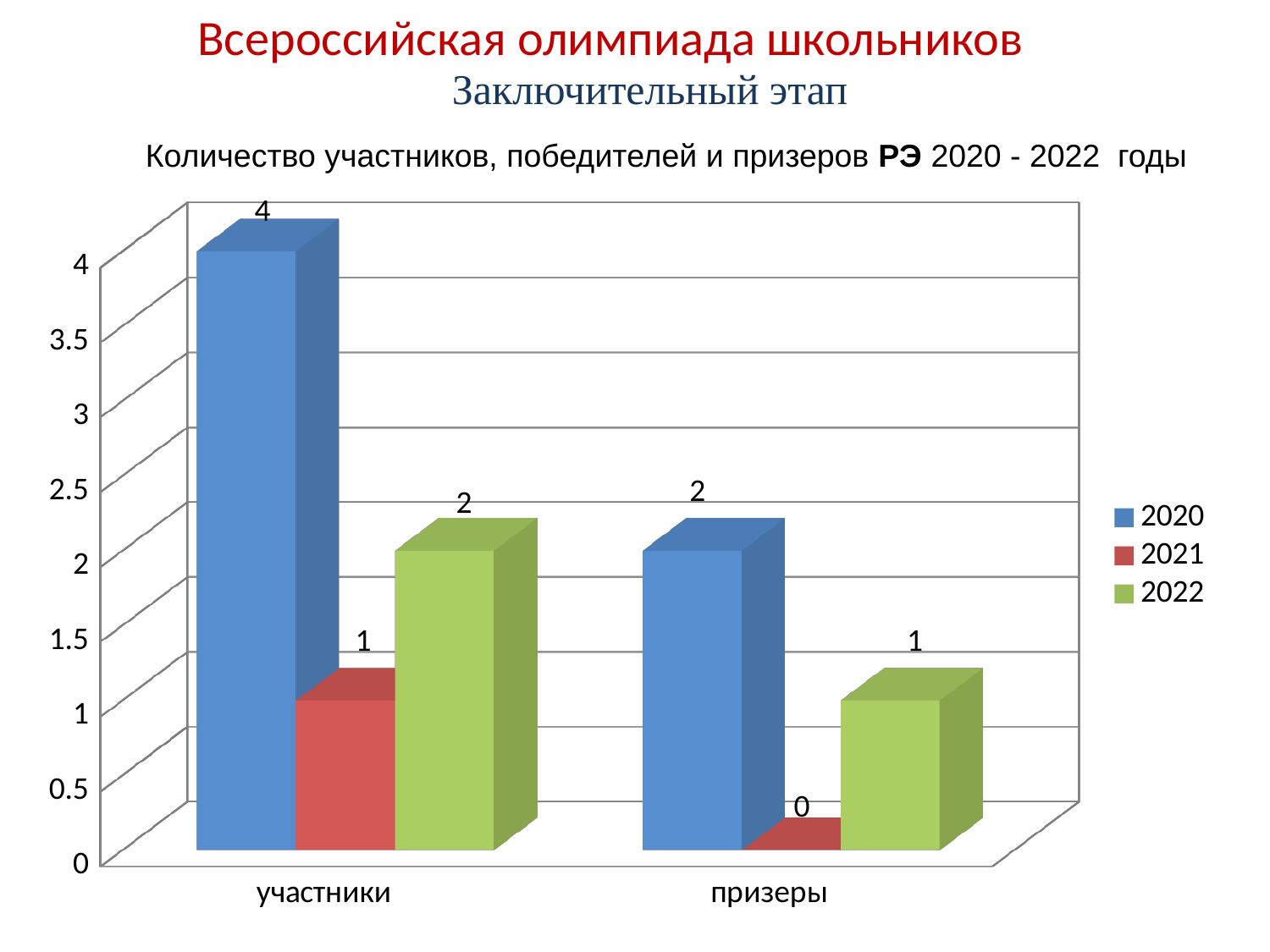
How many categories are shown on the x axis? 2 Which year has the highest value in the участники category? 2020 What is the value for 2022 in the участники category? 2 What kind of chart is shown on the slide? bar chart What is the difference between the 2020 and 2022 values in the участники category? 2 Which is larger: the 2022 value for участники or the 2022 value for призеры? участники What is the value for 2020 in the призеры category? 2 Which year has the lowest value in the призеры category? 2021 How many series does the legend list? 3 Which colour represents the 2021 series in the legend? red What is the value for 2021 in the призеры category? 0 What is the value for 2020 in the участники category? 4